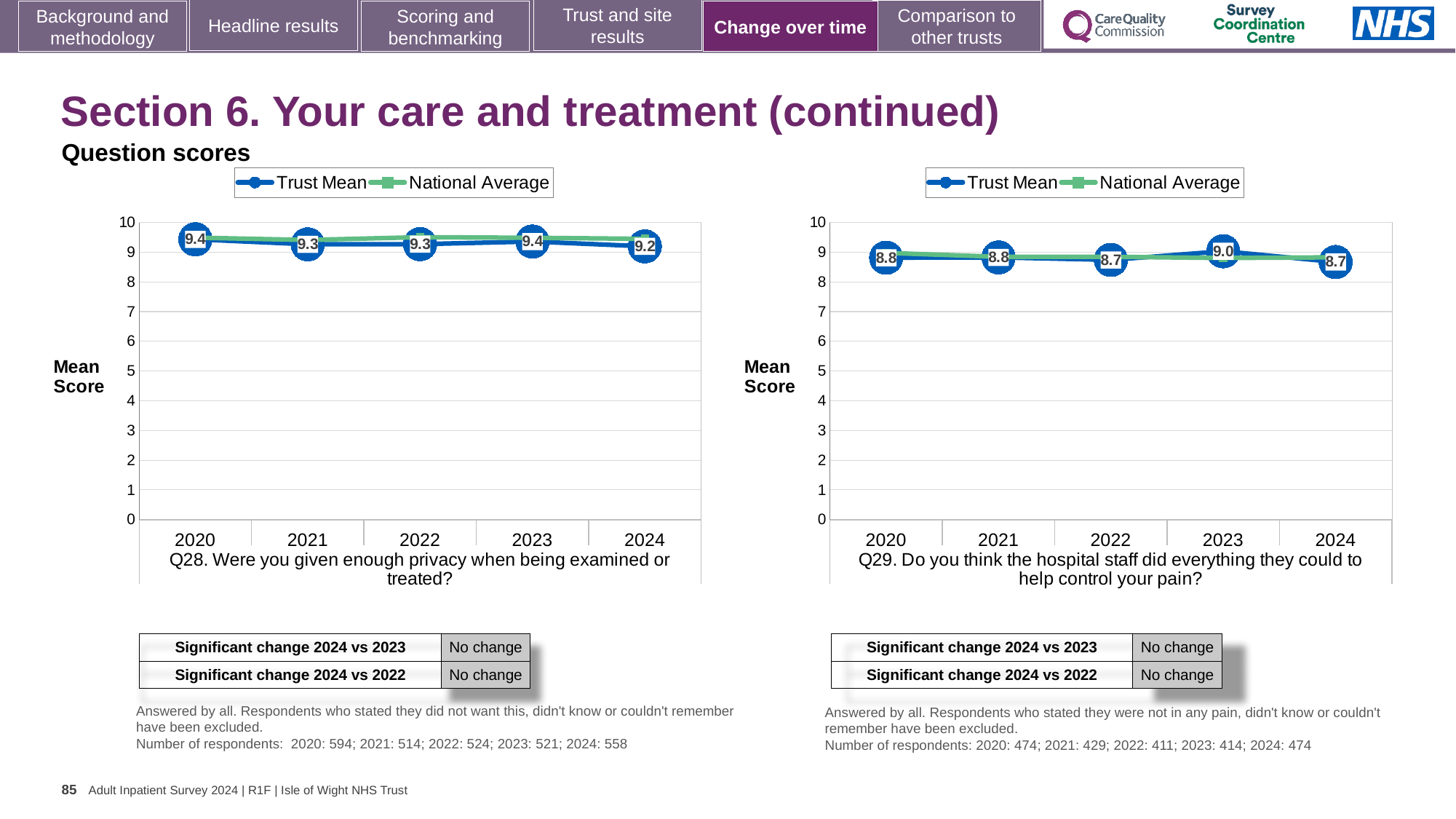
In the Q28 chart (left), what is the difference between the Trust Mean scores for 2020 and 2024? 0.2 In the Q28 chart (left), what is the Trust Mean score for 2024? 9.2 In the Q28 chart (left), which year has the lowest Trust Mean score? 2024 In the Q28 chart (left), is the National Average value for 2022 greater or less than 8? greater In the Q29 chart (right), what is the Trust Mean score for 2023? 9.0 In the Q29 chart (right), which year has the highest Trust Mean score? 2023 How many years are plotted on the x axis of the Q28 chart (left)? 5 In the Q29 chart (right), what is the difference between the Trust Mean scores for 2023 and 2024? 0.3 What kind of chart is the Q28 chart (left)? Line chart How many series does the legend of the Q29 chart (right) list? 2 In the Q29 chart (right), which year has the larger Trust Mean score, 2022 or 2023? 2023 In the Q28 chart (left), does the Trust Mean score rise or fall from 2023 to 2024? Fall